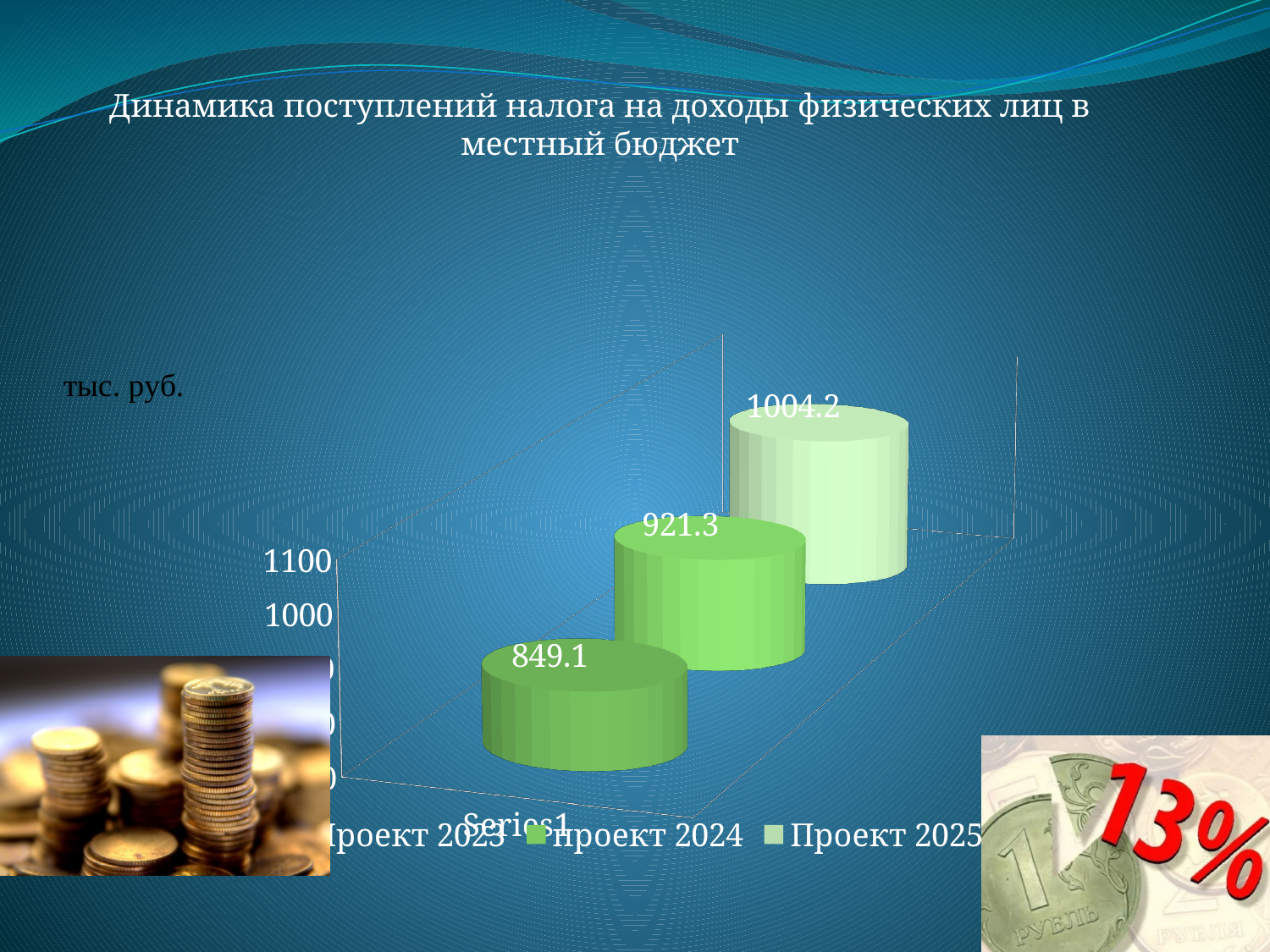
What is the value for Проект 2023? 849.1 Which is larger, the value for Проект 2024 or the value for Проект 2025? Проект 2025 What is the difference between the values for Проект 2025 and Проект 2024? 82.9 What kind of chart is shown on the slide? bar chart Which series has the lowest value? Проект 2023 Which series has the highest value? Проект 2025 What unit of measurement is indicated for the chart values? тыс. руб. What is the value for Проект 2024? 921.3 What is the value for Проект 2025? 1004.2 Is the value for Проект 2025 greater or less than 1000? greater What is the difference between the values for Проект 2024 and Проект 2023? 72.2 How many series does the legend list? 3